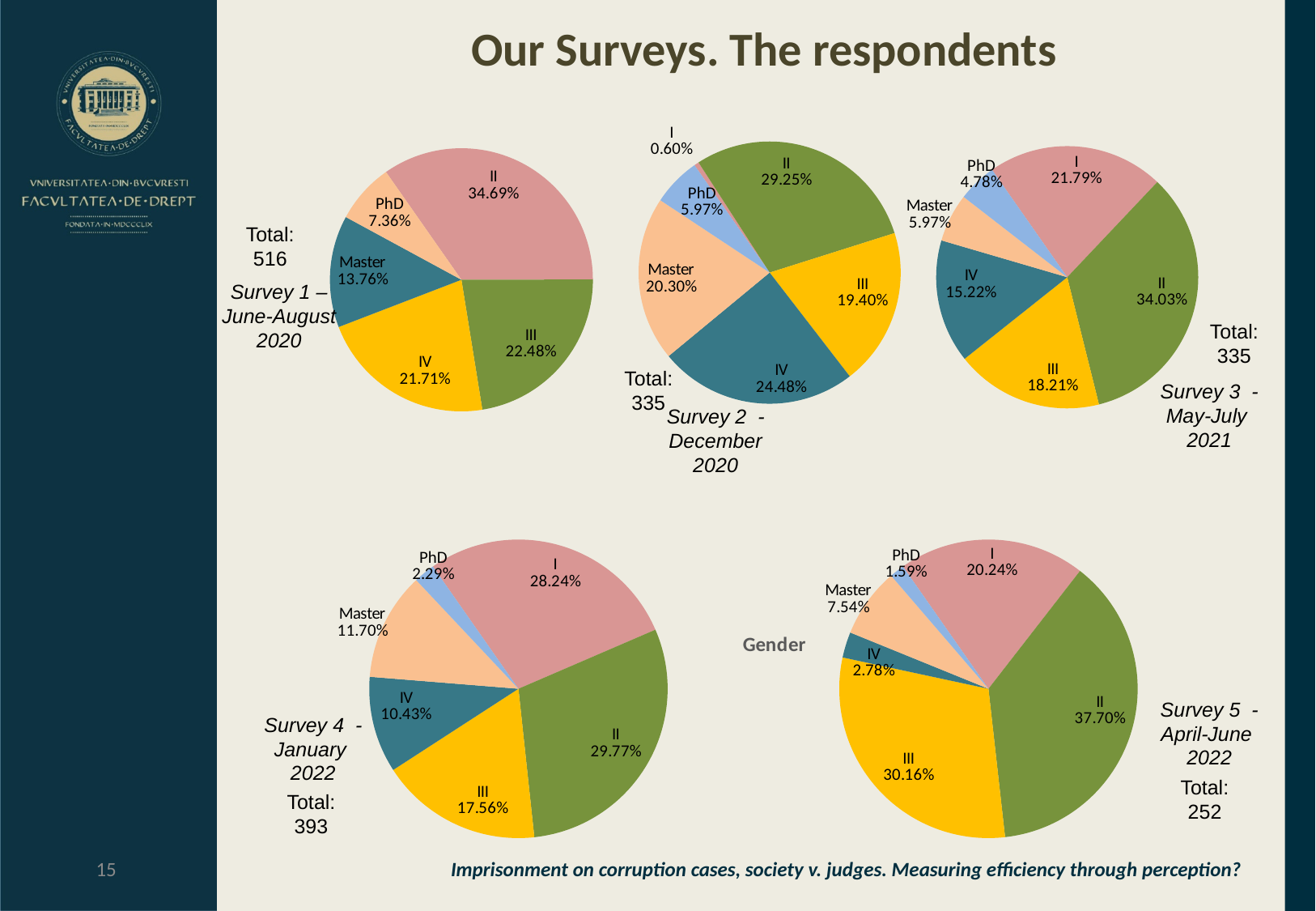
In the Survey 4 (January 2022) pie chart, what is the difference between the shares for II and III? 12.21% In the Survey 2 (December 2020) pie chart, which is larger, the share for IV or the share for III? IV How many pie charts are shown on the slide? 5 How many slices does the Survey 1 (June-August 2020) pie chart have? 5 In the Survey 1 (June-August 2020) pie chart, what share of respondents is labelled II? 34.69% In the Survey 5 (April-June 2022) pie chart, what share of respondents is labelled IV? 2.78% What is the total number of respondents shown for Survey 4 (January 2022)? 393 What type of chart is used for Survey 3 (May-July 2021)? Pie chart How many slices does the Survey 2 (December 2020) pie chart have? 6 In the Survey 2 (December 2020) pie chart, what share of respondents is labelled Master? 20.30% In the Survey 5 (April-June 2022) pie chart, which category has the smallest share? PhD In the Survey 3 (May-July 2021) pie chart, which category has the largest share? II